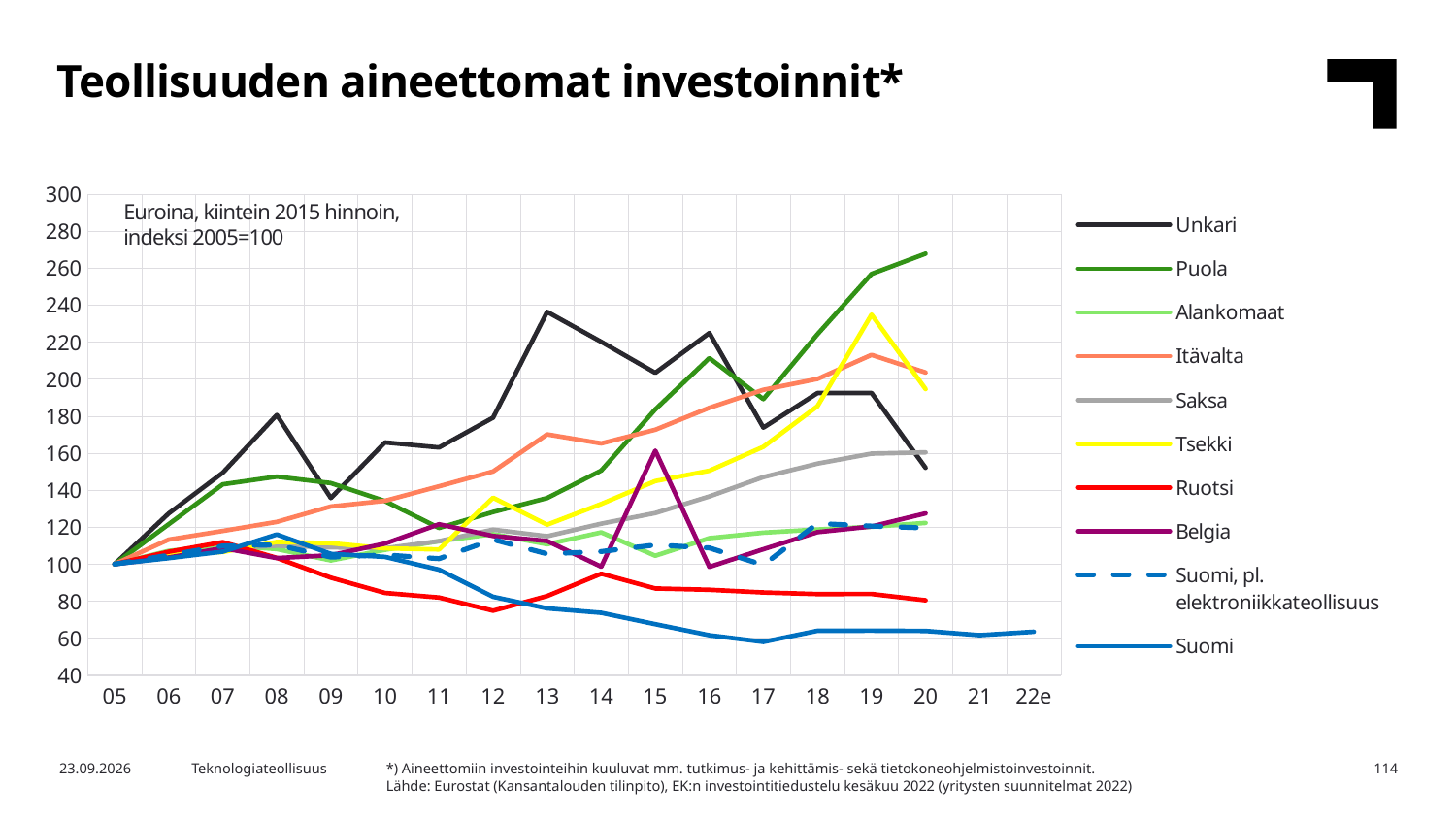
Which series has the highest value in 20? Puola Which series has the highest value in 13? Unkari Is the value for Ruotsi in 20 greater or less than 100? less Is the value for Tsekki in 19 greater or less than 220? greater Does the Ruotsi series generally rise or fall from 05 to 20? fall How many year labels are shown on the x axis? 18 How many series does the legend list? 10 Is the value for Puola in 20 greater or less than 260? greater Which is larger in 20, the value for Puola or the value for Unkari? Puola Which series has the lowest value in 20? Suomi Which series is the only one that extends to 22e on the x axis? Suomi What kind of chart is shown on the slide? line chart